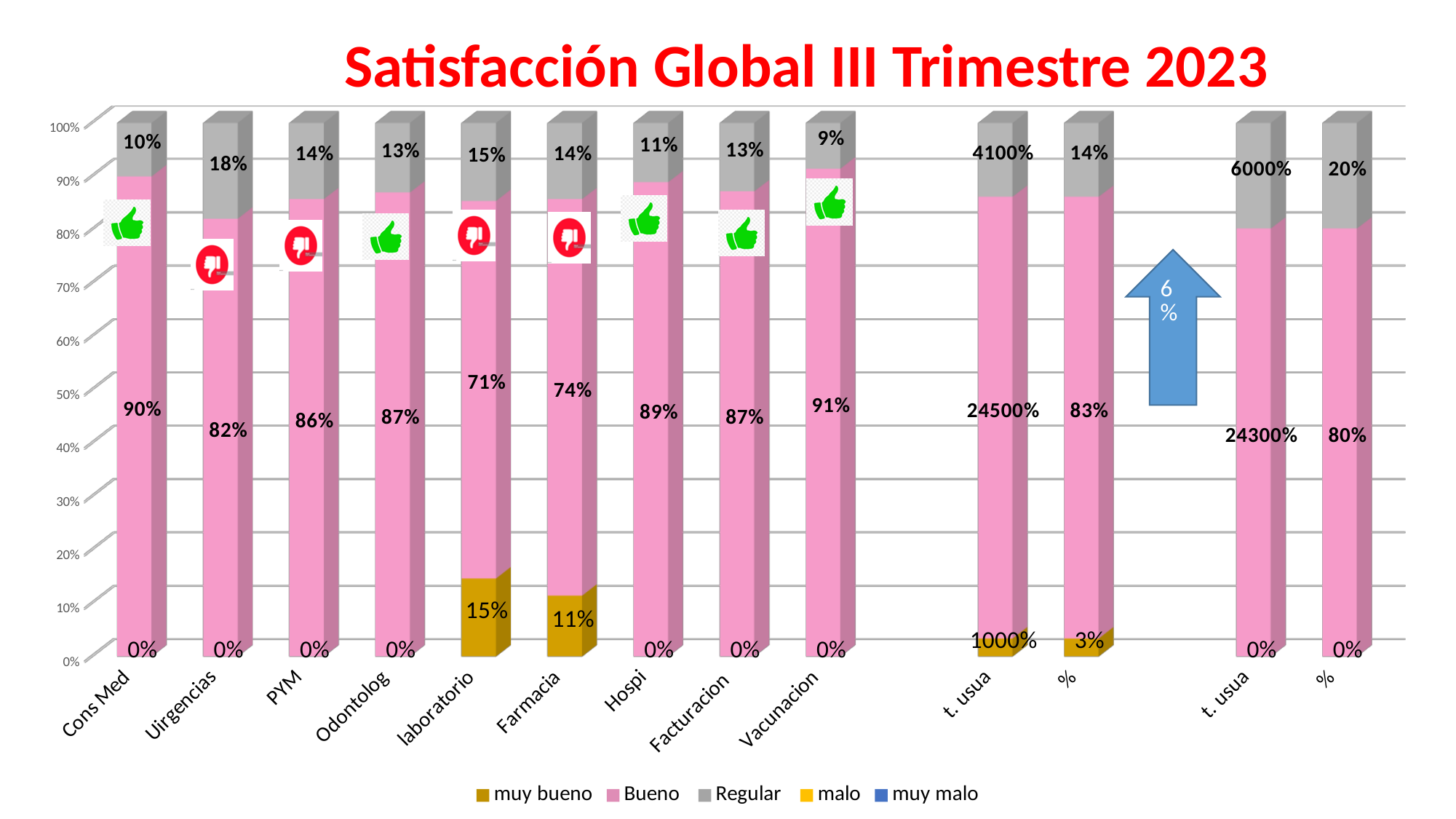
Among Cons Med, Uirgencias, PYM, Odontolog, laboratorio, Farmacia, Hospi, Facturacion and Vacunacion, which category has the highest Bueno value? Vacunacion What is the Bueno value for the rightmost bar, labelled %? 80% What is the muy bueno value for laboratorio? 15% Which has a larger Regular value, Uirgencias or Hospi? Uirgencias What is the title of the chart? Satisfacción Global III Trimestre 2023 What type of chart is shown on the slide? stacked bar chart What is the Regular value for Uirgencias? 18% How many series does the legend list? 5 What is the muy bueno value for Farmacia? 11% What is the difference between the Bueno values for Vacunacion and laboratorio? 20% What is the Bueno value for Cons Med? 90% Among Cons Med, Uirgencias, PYM, Odontolog, laboratorio, Farmacia, Hospi, Facturacion and Vacunacion, which category has the lowest Bueno value? laboratorio